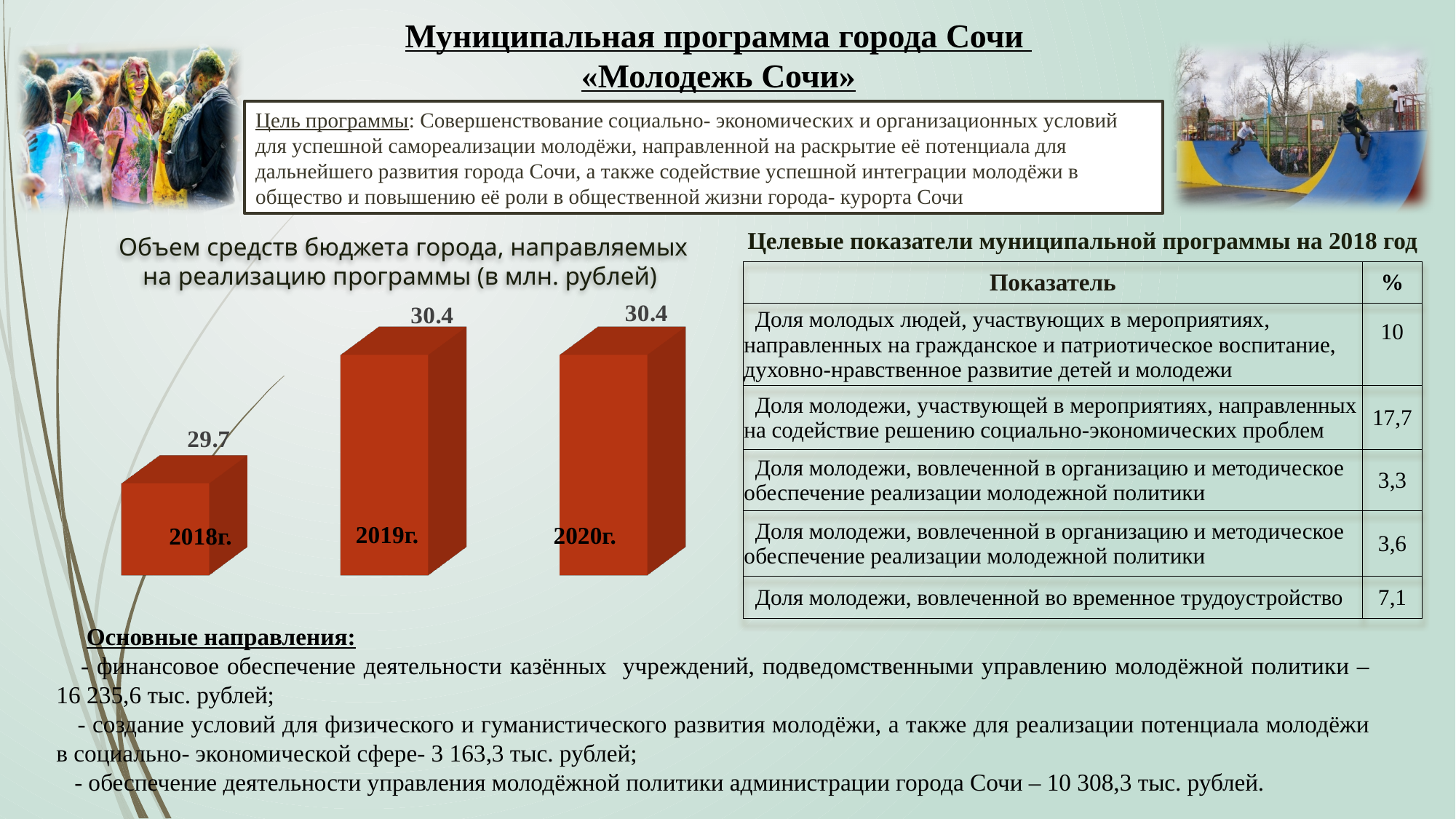
How many years are shown in the chart? 3 Which year has the lowest value in the chart? 2018г. What is the value for 2020г. in the chart? 30.4 What is the value for 2018г. in the chart? 29.7 What unit are the chart values given in, according to the title? млн. рублей Does the value rise or fall from 2018г. to 2019г.? Rise What is the difference between the values for 2019г. and 2018г.? 0.7 Which is larger, the value for 2018г. or the value for 2019г.? 2019г. What is the value for 2019г. in the chart? 30.4 What is the title of the chart? Объем средств бюджета города, направляемых на реализацию программы (в млн. рублей) What kind of chart is shown on the slide? Bar chart Which is larger, the value for 2020г. or the value for 2018г.? 2020г.